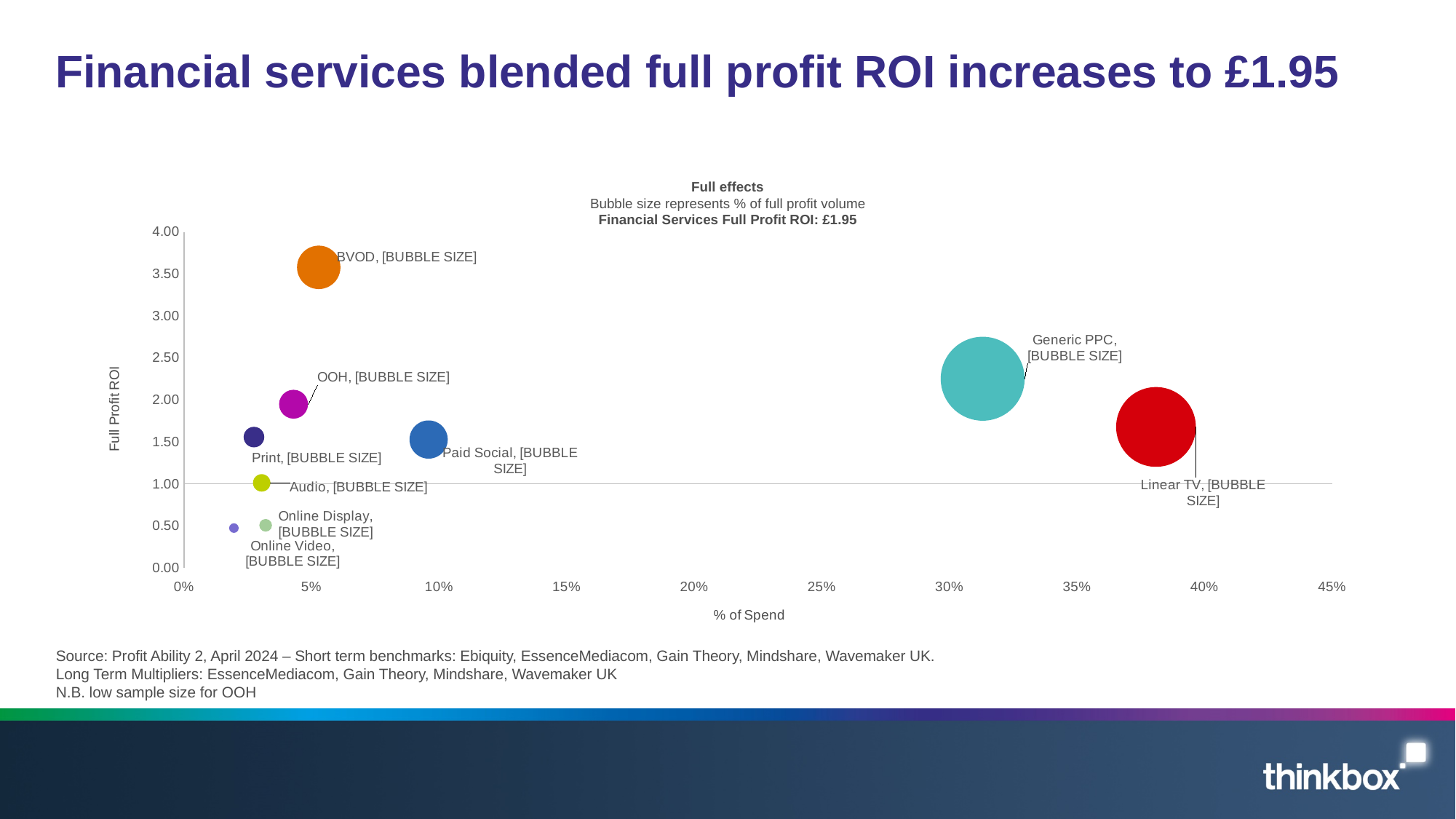
Is the Full Profit ROI for Online Display greater or less than 1.00? less How many media channels (bubbles) are plotted on the chart? 9 Is the % of Spend for Linear TV greater or less than 35%? greater Is the Full Profit ROI for Generic PPC greater or less than 2.00? greater Which has the higher % of Spend, Paid Social or Print? Paid Social Which channel has the highest % of Spend? Linear TV What kind of chart is shown on the slide? Bubble chart Which channel has the highest Full Profit ROI? BVOD According to the chart subtitle, what does the bubble size represent? % of full profit volume Which has the higher Full Profit ROI, BVOD or Generic PPC? BVOD